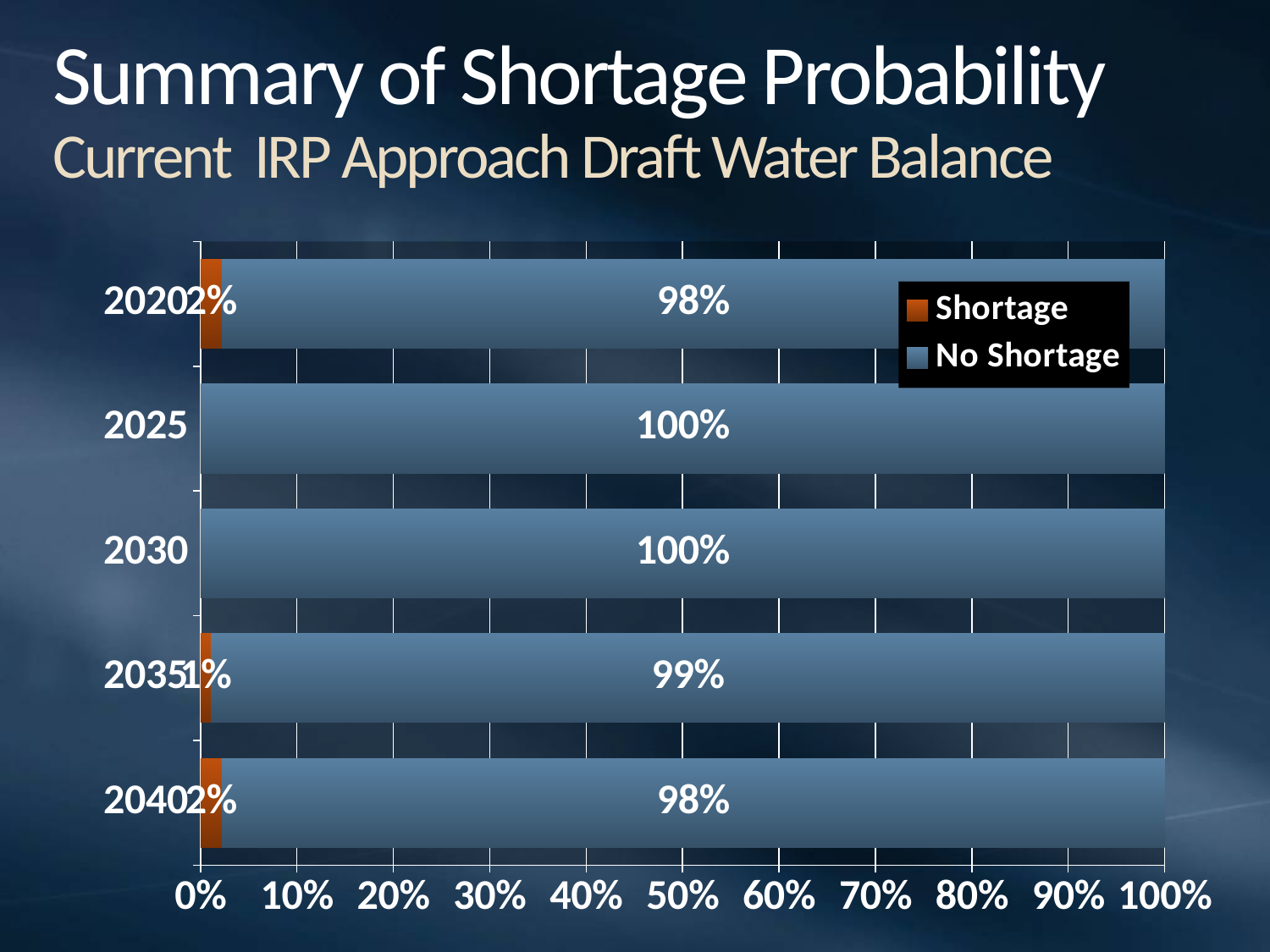
What is the No Shortage value for 2035? 99% Which year has the lowest No Shortage value, 2035 or 2040? 2040 What is the total of the stacked bar for 2040? 100% What is the No Shortage value for 2025? 100% What is the Shortage value for 2035? 1% What is the difference between the No Shortage values for 2025 and 2020? 2% What is the No Shortage value for 2020? 98% What kind of chart is shown on the slide? Stacked bar chart How many series does the legend list? 2 Which series is shown in orange in the legend? Shortage What is the Shortage value for 2040? 2% How many years are shown on the chart? 5